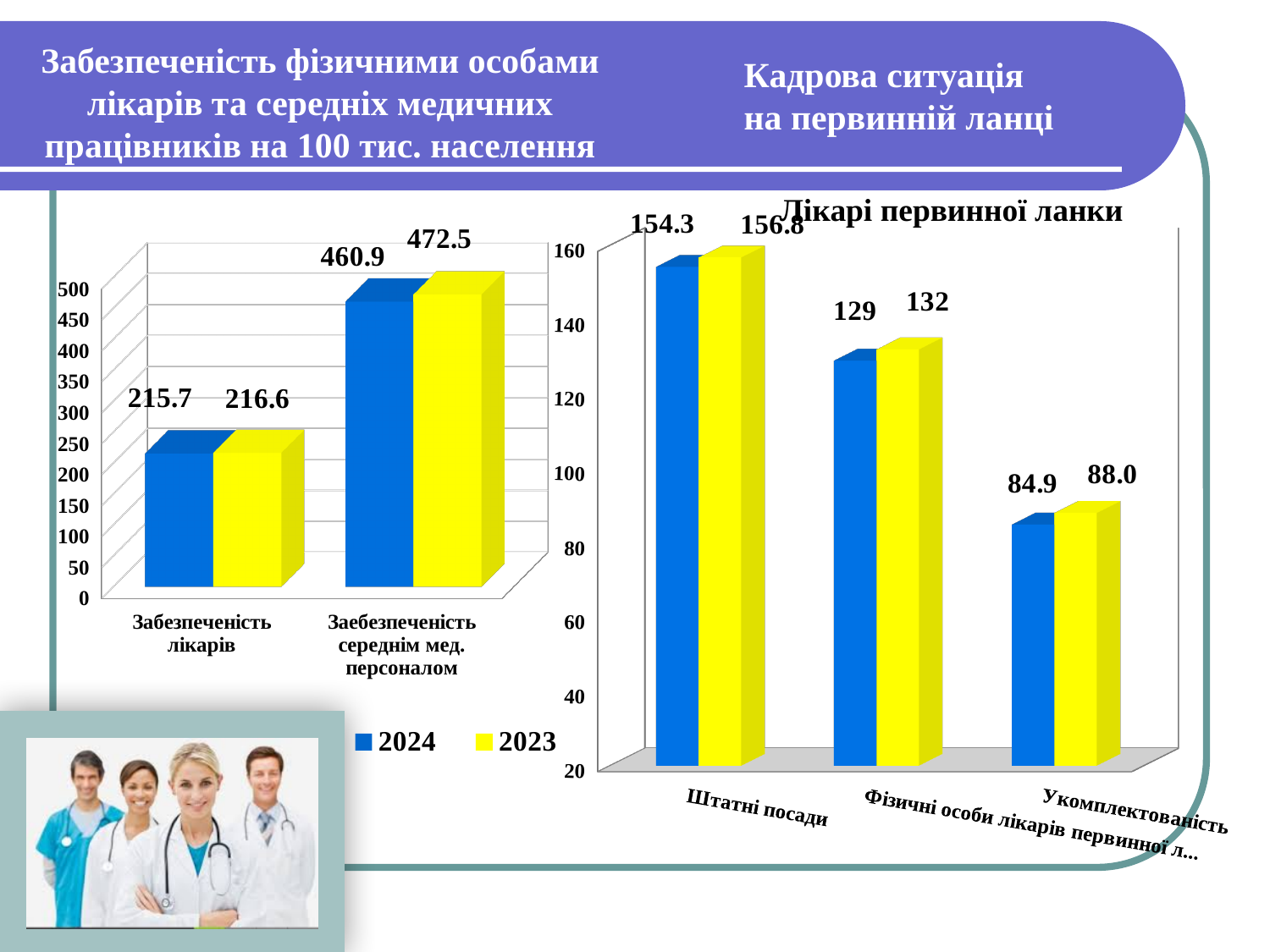
In the chart titled Лікарі первинної ланки, what is the difference between the 2023 and 2024 values for Фізичні особи лікарів первинної ланки? 3 In the left chart, what is the difference between the 2023 and 2024 values for Заебезпеченість середнім мед. персоналом? 11.6 How many series does the legend of the left chart list? 2 In the chart titled Лікарі первинної ланки, do the values rise or fall from left to right along the x axis? Fall In the chart titled Лікарі первинної ланки, how many categories are shown on the x axis? 3 In the left chart (Забезпеченість фізичними особами лікарів та середніх медичних працівників на 100 тис. населення), what is the 2024 value for Забезпеченість лікарів? 215.7 In the chart titled Лікарі первинної ланки, which category has the lowest values? Укомплектованість In the left chart, what is the 2023 value for Заебезпеченість середнім мед. персоналом? 472.5 In the chart titled Лікарі первинної ланки, what is the 2024 (blue) value for Штатні посади? 154.3 In the chart titled Лікарі первинної ланки, what is the 2023 (yellow) value for Укомплектованість? 88.0 In the left chart, which category has the highest values? Заебезпеченість середнім мед. персоналом What kind of chart is the left chart? Bar chart